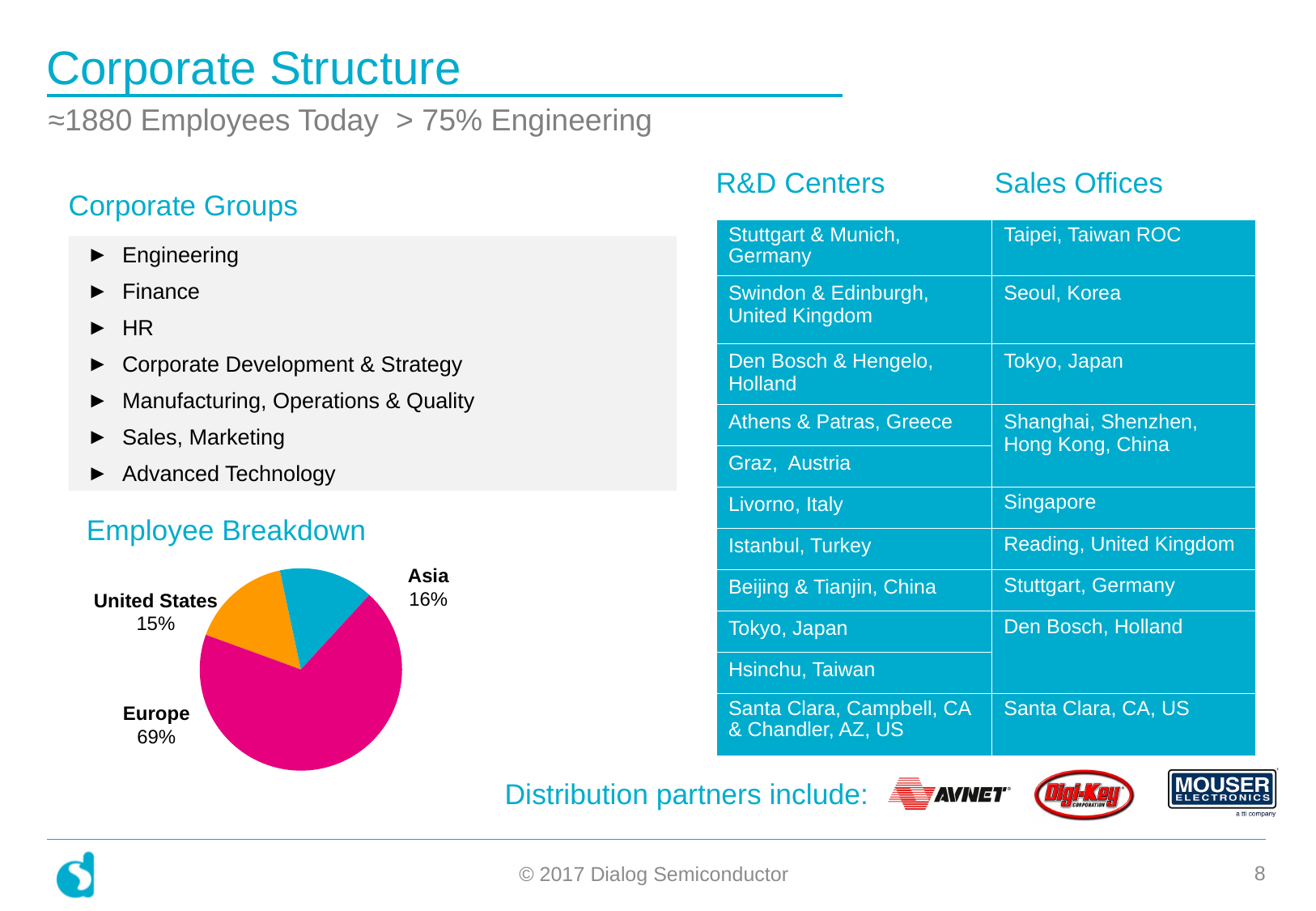
What share of employees is in Europe according to the Employee Breakdown pie chart? 69% What share of employees is in Asia according to the Employee Breakdown pie chart? 16% How many regions are shown in the Employee Breakdown pie chart? 3 What is the title of the chart on the slide? Employee Breakdown Which region has the smallest share in the Employee Breakdown pie chart? United States What kind of chart is the Employee Breakdown chart? Pie chart What colour is the Europe slice in the Employee Breakdown pie chart? Magenta (pink) What is the combined share of Asia and the United States in the Employee Breakdown pie chart? 31% What is the difference in percentage points between the Asia and United States shares in the Employee Breakdown pie chart? 1 What share of employees is in the United States according to the Employee Breakdown pie chart? 15% What is the difference in percentage points between the Europe and Asia shares in the Employee Breakdown pie chart? 53 Which region has the largest share in the Employee Breakdown pie chart? Europe